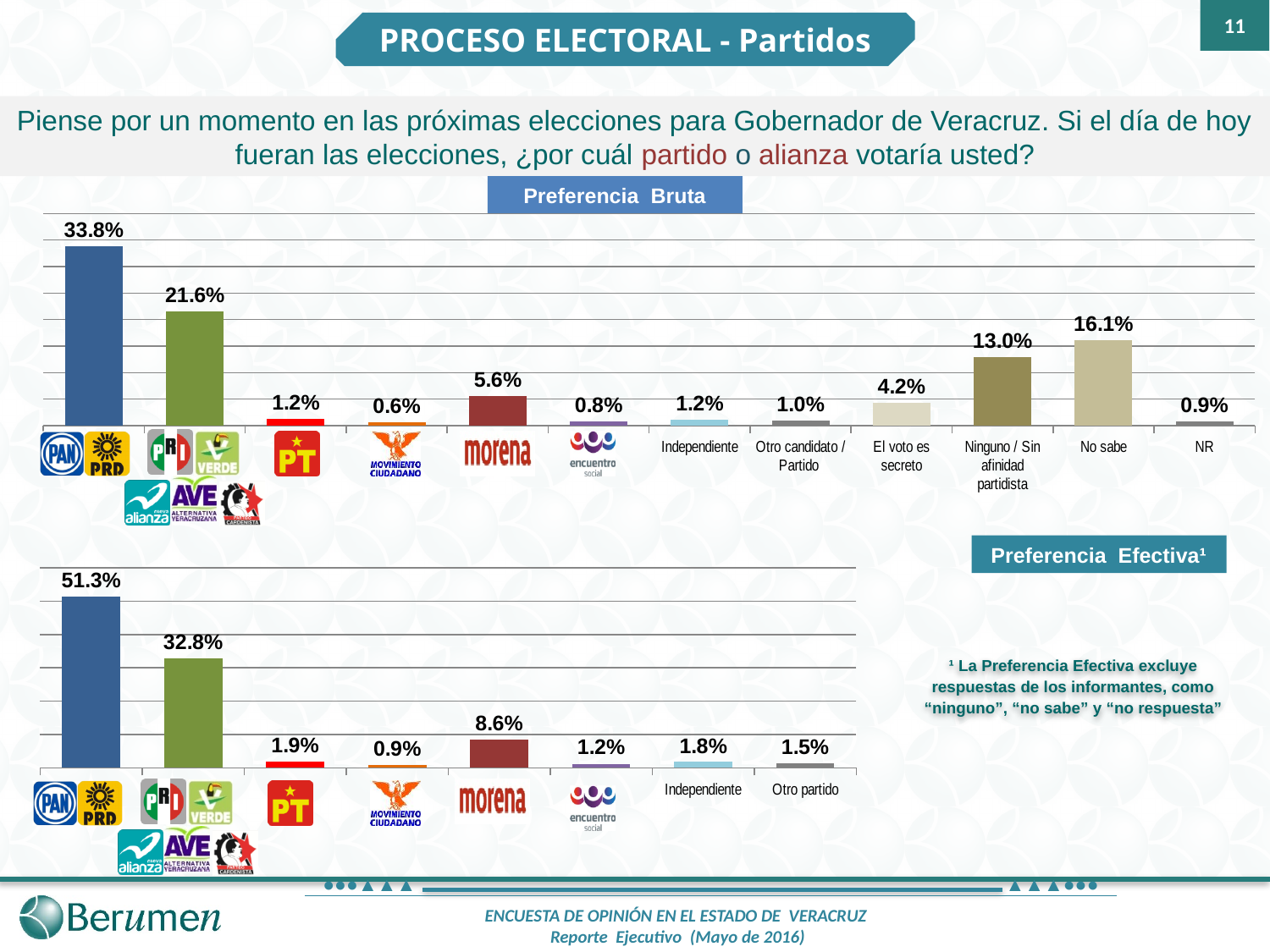
In the Preferencia Efectiva chart, what is the difference between the first bar (PAN-PRD alliance) and the second bar (PRI alliance)? 18.5% In the Preferencia Bruta chart, what is the value for Ninguno / Sin afinidad partidista? 13.0% In the Preferencia Bruta chart, which category has the highest value? PAN-PRD alliance (33.8%) In the Preferencia Bruta chart, which category has the lowest value? Movimiento Ciudadano (0.6%) In the Preferencia Efectiva chart, which is larger: the value for PT or the value for Otro partido? PT (1.9%) How many categories are shown in the Preferencia Bruta chart? 12 In the Preferencia Bruta chart, what is the value for No sabe? 16.1% In the Preferencia Efectiva chart, what is the value for Independiente? 1.8% In the Preferencia Bruta chart, what is the difference between the value for No sabe and the value for Ninguno / Sin afinidad partidista? 3.1% In the Preferencia Efectiva chart, what is the value for Morena? 8.6% In the Preferencia Bruta chart, what is the value for Morena? 5.6% What type of chart is used for Preferencia Efectiva? Bar chart